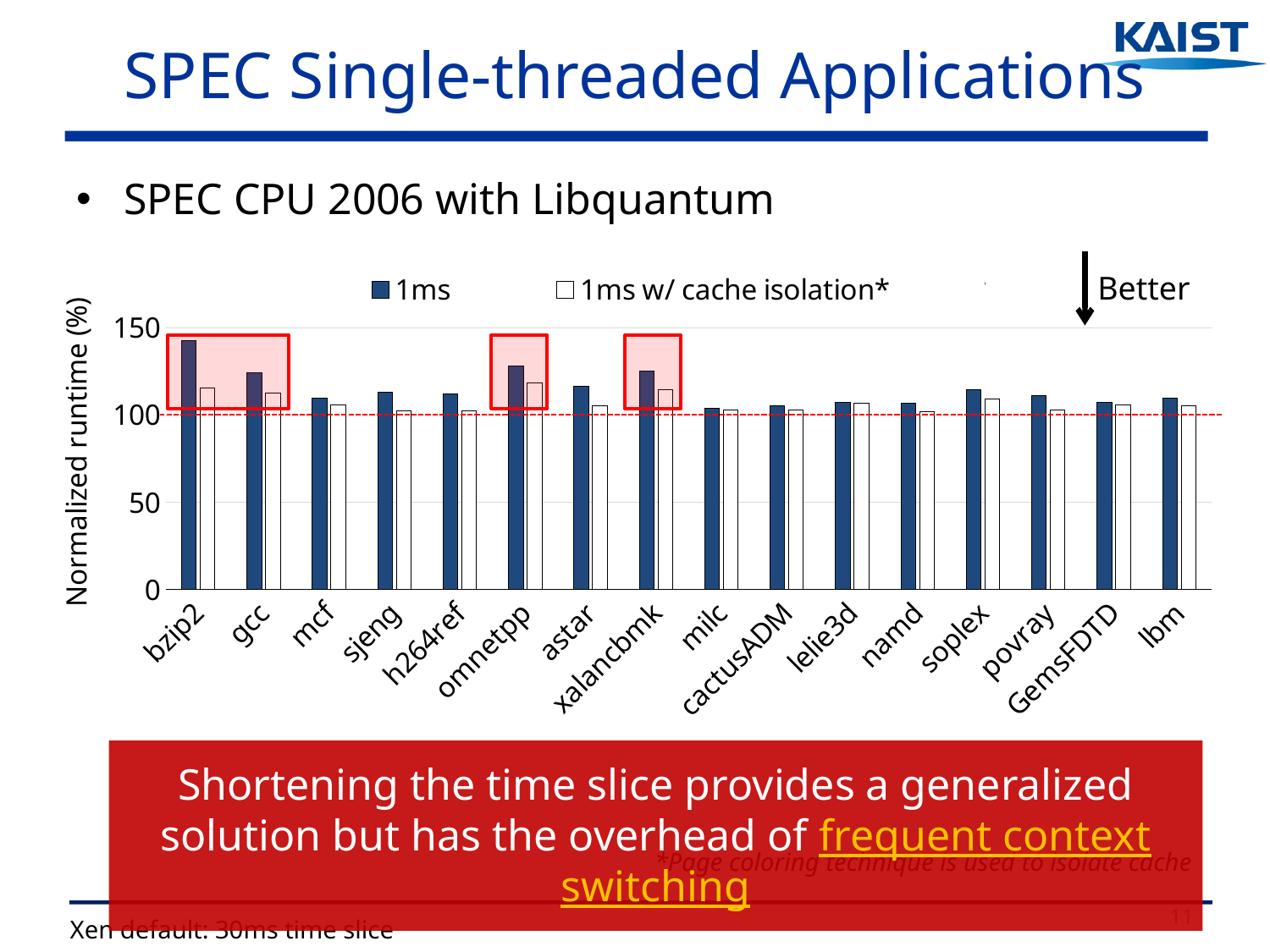
What are the two legend entries of the chart? 1ms and 1ms w/ cache isolation* Which application has the highest normalized runtime for the 1ms series? bzip2 Is the 1ms value for bzip2 greater or less than 150? less Which is larger for bzip2: the 1ms value or the 1ms w/ cache isolation* value? 1ms Is the 1ms w/ cache isolation* value for mcf greater or less than 150? less What kind of chart is shown on the slide? bar chart Is the 1ms value for gcc greater or less than 100? greater How many application categories are shown on the x axis of the chart? 16 How many series does the chart legend list? 2 What is the label of the y axis of the chart? Normalized runtime (%) Which has the larger 1ms value: bzip2 or omnetpp? bzip2